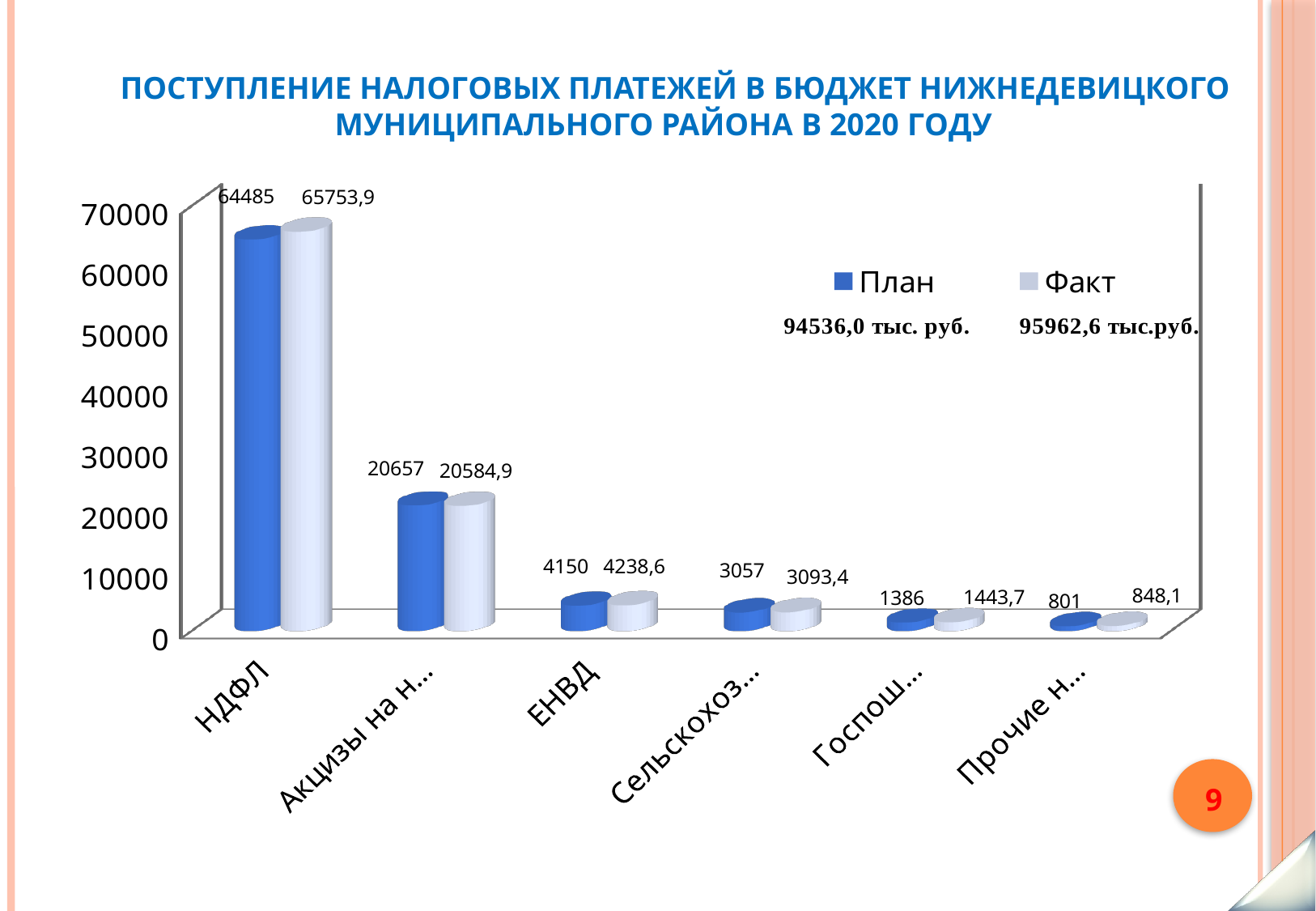
What is the План value for ЕНВД? 4150 How many series does the legend list? 2 Which category has the highest План value? НДФЛ How many categories are shown on the x axis? 6 What is the Факт value for НДФЛ? 65753,9 Which category has the lowest Факт value? Прочие н... Which is larger for НДФЛ, the План value or the Факт value? Факт What is the Факт value for ЕНВД? 4238,6 What is the План value for НДФЛ? 64485 What is the difference between the Факт and План values for ЕНВД? 88,6 Is the План value for НДФЛ greater or less than 60000? greater What kind of chart is shown on the slide? bar chart